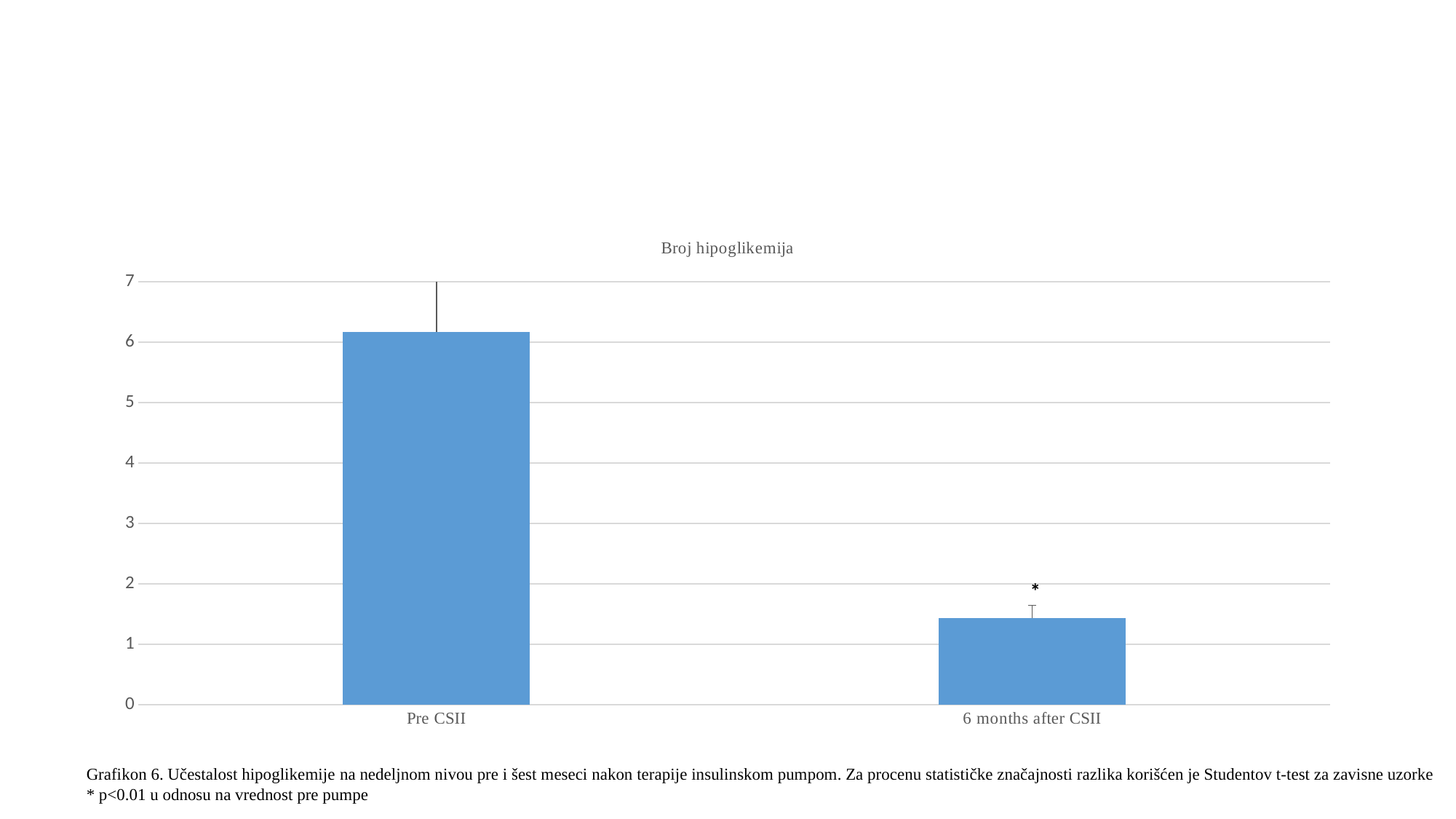
Which category has the highest value in the chart? Pre CSII How many categories are shown on the x axis of the chart? 2 Is the value for 6 months after CSII greater or less than 1? greater What is the highest tick value shown on the y axis of the chart? 7 What is the title of the chart? Broj hipoglikemija Is the value for Pre CSII greater or less than 6? greater Is the value for Pre CSII greater or less than 7? less What kind of chart is shown on the slide? bar chart Which is larger, the value for Pre CSII or the value for 6 months after CSII? Pre CSII Do the values rise or fall from Pre CSII to 6 months after CSII? fall Which category has the lowest value in the chart? 6 months after CSII